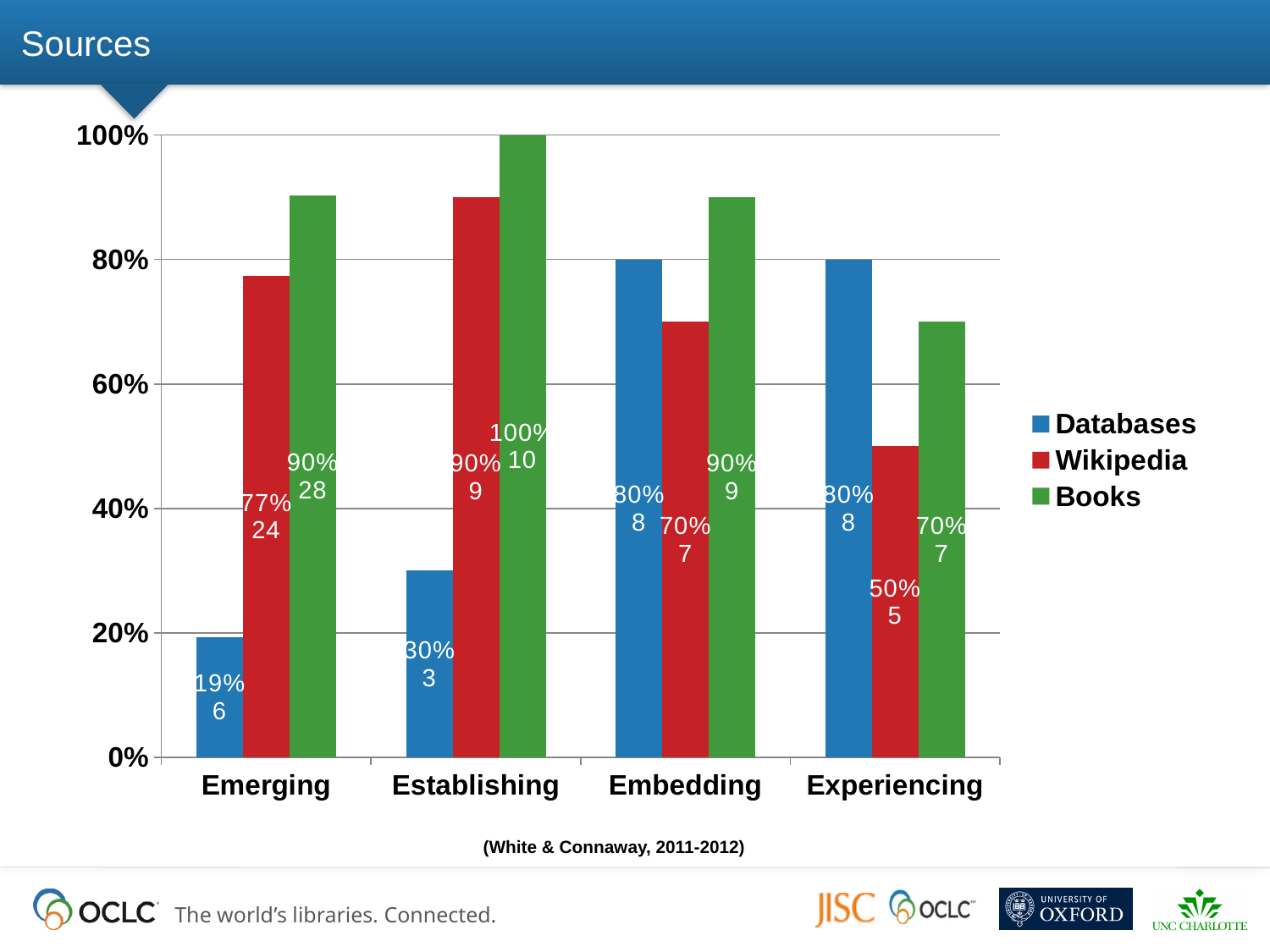
Which category has the lowest value for Databases? Emerging How many series does the legend list? 3 Which category has the highest value for Books? Establishing In the Experiencing category, which is larger, Databases or Wikipedia? Databases What colour represents the Wikipedia series? red How many categories are shown on the x axis? 4 What is the percentage value for Databases in the Establishing category? 30% What is the percentage value for Wikipedia in the Emerging category? 77% What kind of chart is shown on the slide? bar chart Does the value for Databases rise or fall from Emerging to Embedding? rise What is the percentage value for Books in the Experiencing category? 70% What is the difference between the Books and Databases percentages in the Emerging category? 71%